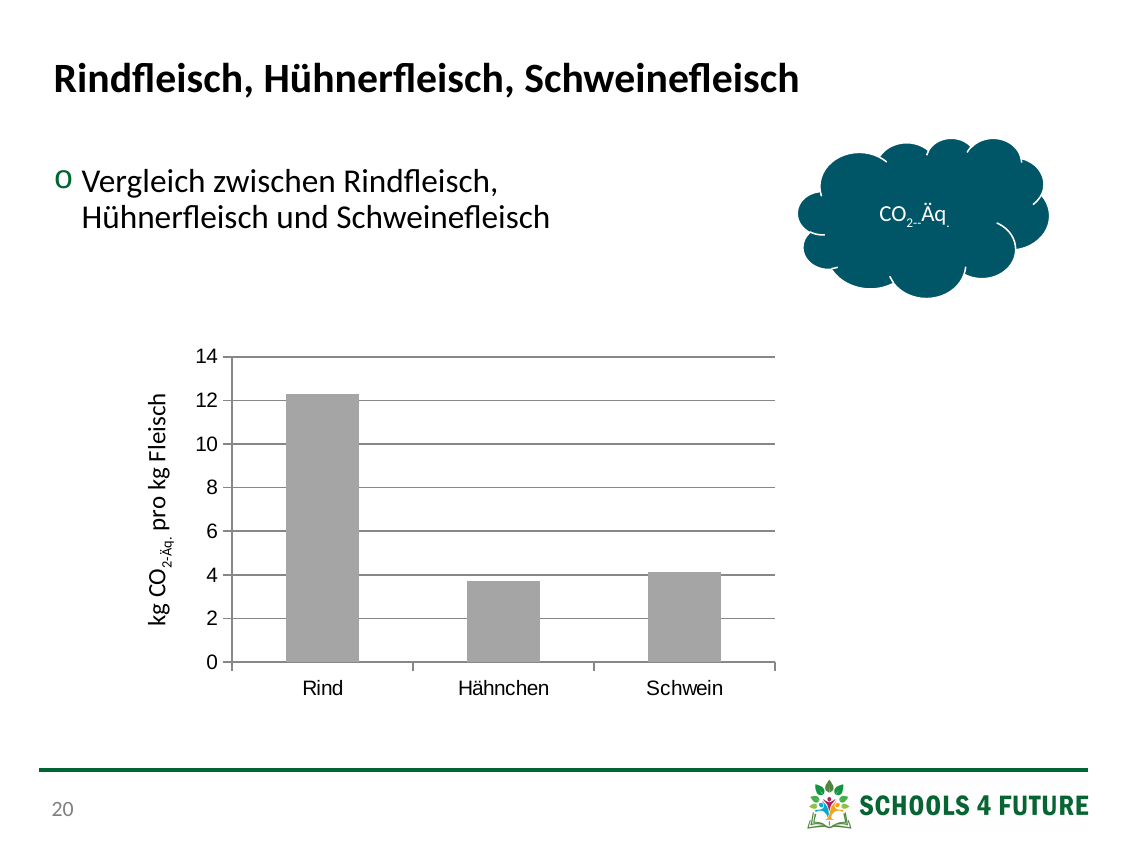
Is the value for Rind greater or less than 14? less What is the label of the vertical axis of the chart? kg CO2-Äq. pro kg Fleisch Is the value for Hähnchen greater or less than 4? less Which is larger, the value for Hähnchen or the value for Schwein? Schwein Which category has the highest value in the chart? Rind How many categories are shown on the x axis of the chart? 3 Is the value for Rind greater or less than 12? greater Do the values rise or fall from Rind to Hähnchen? fall Which category has the lowest value in the chart? Hähnchen Which is larger, the value for Rind or the value for Schwein? Rind What kind of chart is shown on the slide? bar chart